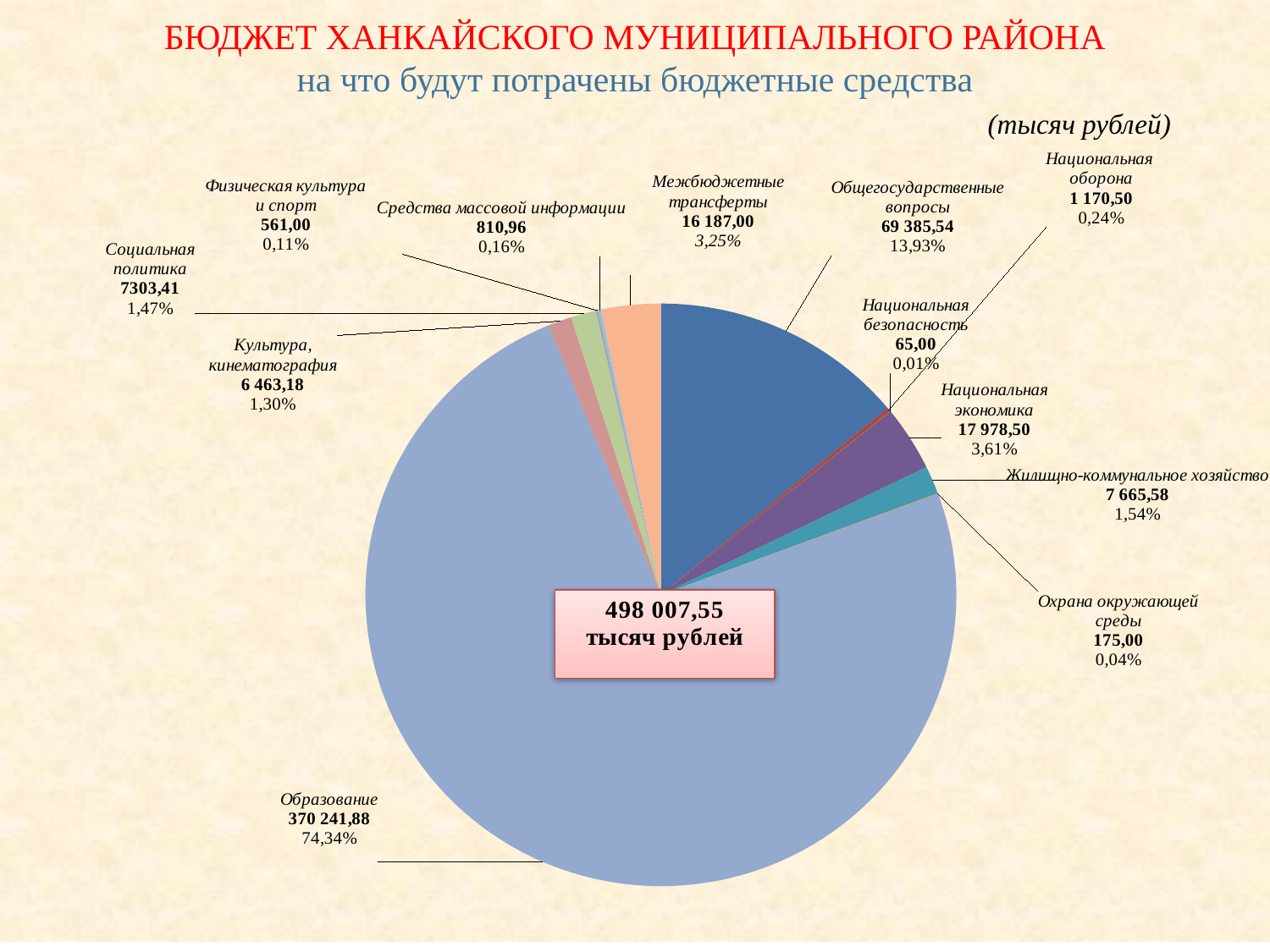
What is the value for Образование? 370 241,88 What unit is stated for the values on the chart? тысяч рублей What is the value for Национальная экономика? 17 978,50 Which category has the smallest slice of the pie? Национальная безопасность Which is larger, Межбюджетные трансферты or Национальная экономика? Национальная экономика What kind of chart is shown on the slide? pie chart What share of the pie does Охрана окружающей среды take? 0,04% How many categories does the pie chart show? 12 What share of the pie does Общегосударственные вопросы take? 13,93% What total amount is shown in the centre of the pie chart? 498 007,55 тысяч рублей Which category has the largest slice of the pie? Образование What is the difference between the values for Жилищно-коммунальное хозяйство and Социальная политика? 362,17